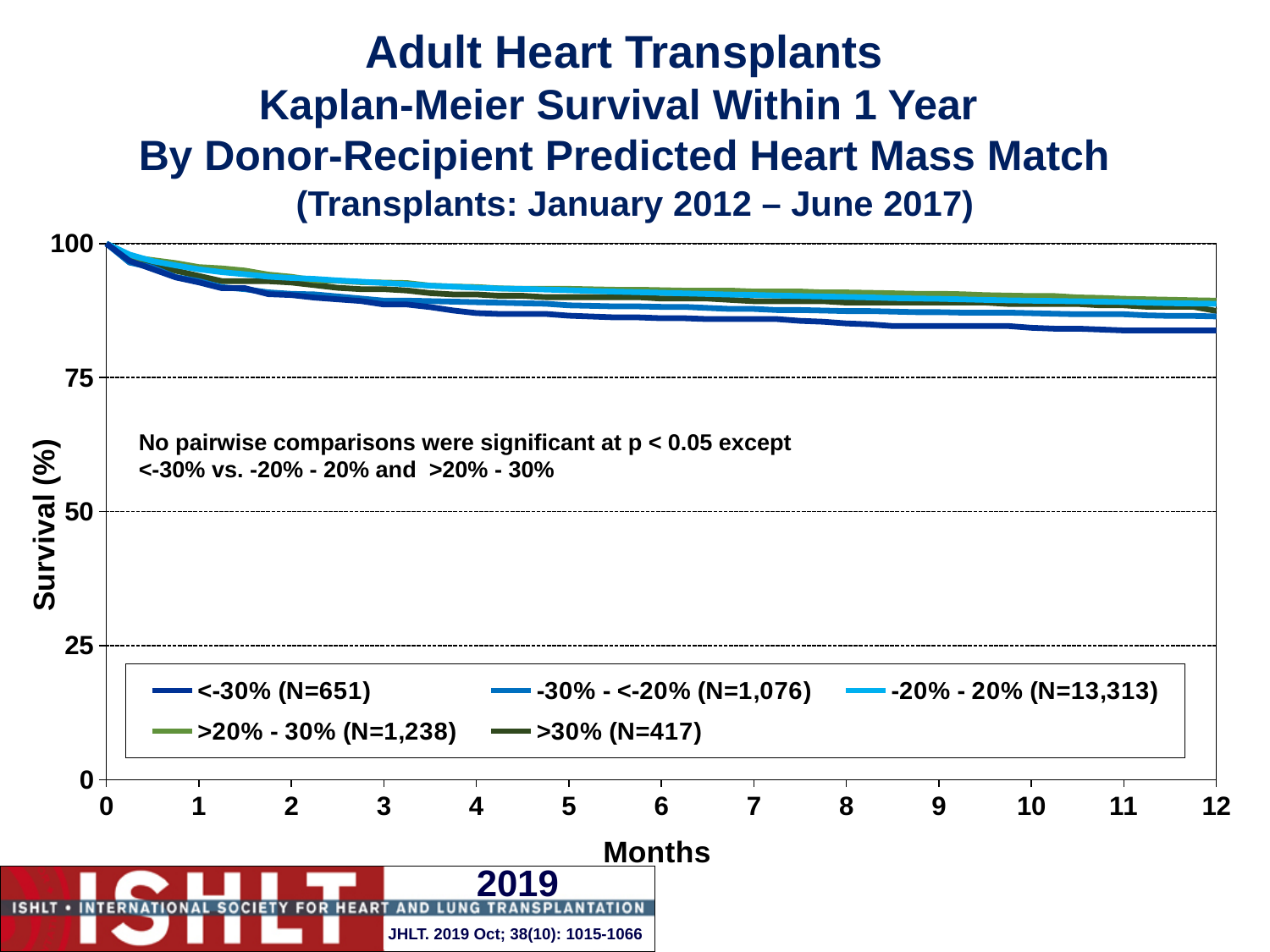
What is the N for the >30% group shown in the legend? 417 What is the label of the y axis? Survival (%) What kind of chart is shown on the slide? Line chart How many series does the legend list? 5 Which group has the lowest survival at 12 months? <-30% (N=651) What is the N for the -20% - 20% group shown in the legend? 13,313 Do the survival curves rise or fall as months increase? Fall At 12 months, which has higher survival: the <-30% group or the -20% - 20% group? -20% - 20% Is the survival for the <-30% group at 12 months greater or less than 75? greater What is the N for the <-30% group shown in the legend? 651 What is the label of the x axis? Months What is the N for the >20% - 30% group shown in the legend? 1,238